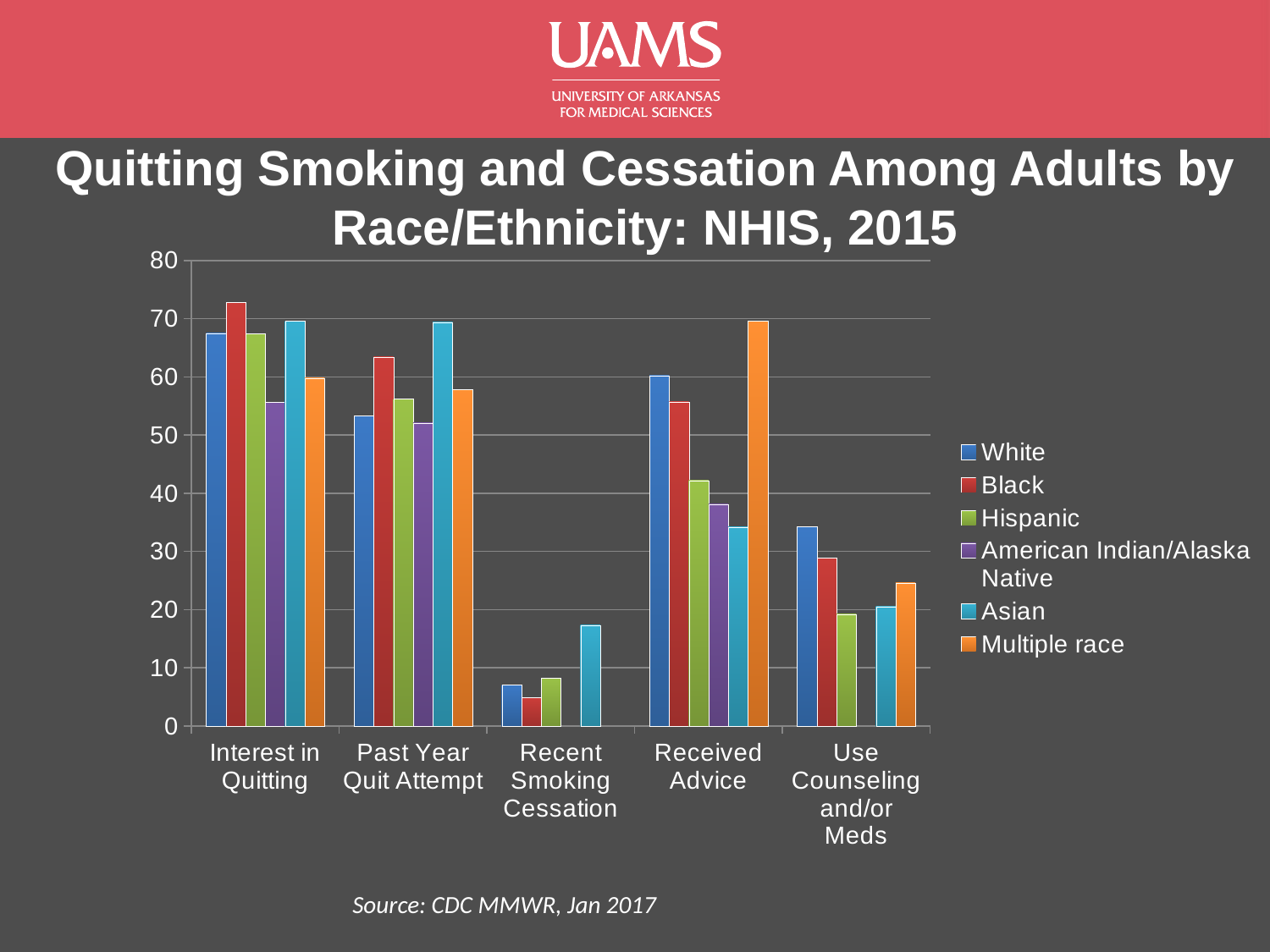
Within the Received Advice category, which race/ethnicity group has the lowest bar? Asian In the Past Year Quit Attempt category, which is larger: the value for Asian or the value for White? Asian Is the value for White in the Use Counseling and/or Meds category greater or less than 30? greater Within the Past Year Quit Attempt category, which race/ethnicity group has the highest bar? Asian What kind of chart is shown on the slide? bar chart Which race/ethnicity group is represented by the orange bars? Multiple race Is the value for Asian in the Recent Smoking Cessation category greater or less than 10? greater Within the Received Advice category, which race/ethnicity group has the highest bar? Multiple race Is the value for Multiple race in the Received Advice category greater or less than 60? greater Within the Interest in Quitting category, which race/ethnicity group has the highest bar? Black How many series does the legend list? 6 How many categories are shown along the x axis? 5